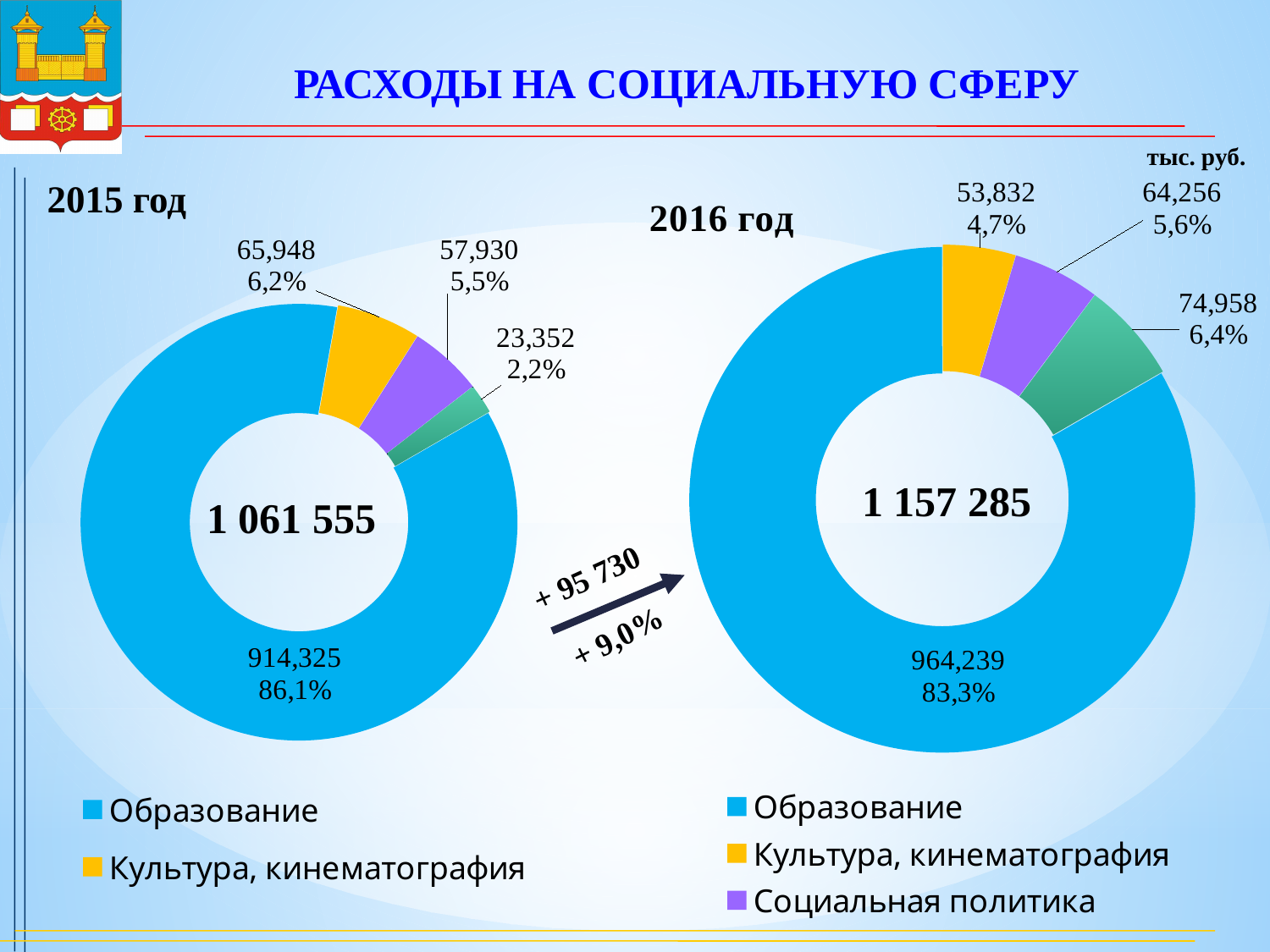
What is the difference between the Образование value in the 2016 год chart and in the 2015 год chart? 49,914 In the 2016 год chart, which is larger: Культура, кинематография or Социальная политика? Социальная политика In the 2016 год chart, what share of the total does Культура, кинематография account for? 4,7% In the 2016 год chart, what is the value for Социальная политика? 64,256 In the 2015 год chart, what is the value for Образование? 914,325 In the 2016 год chart, what is the value for Образование? 964,239 In the 2016 год chart, which category has the largest slice? Образование What kind of chart is used for the 2015 год and 2016 год data? doughnut chart In the 2016 год chart, what is the difference between Социальная политика and Культура, кинематография? 10,424 In the 2015 год chart, what share of the total does Образование account for? 86,1% In the 2015 год chart, what is the value for Культура, кинематография? 65,948 How many entries does the legend of the 2016 год chart list? 3